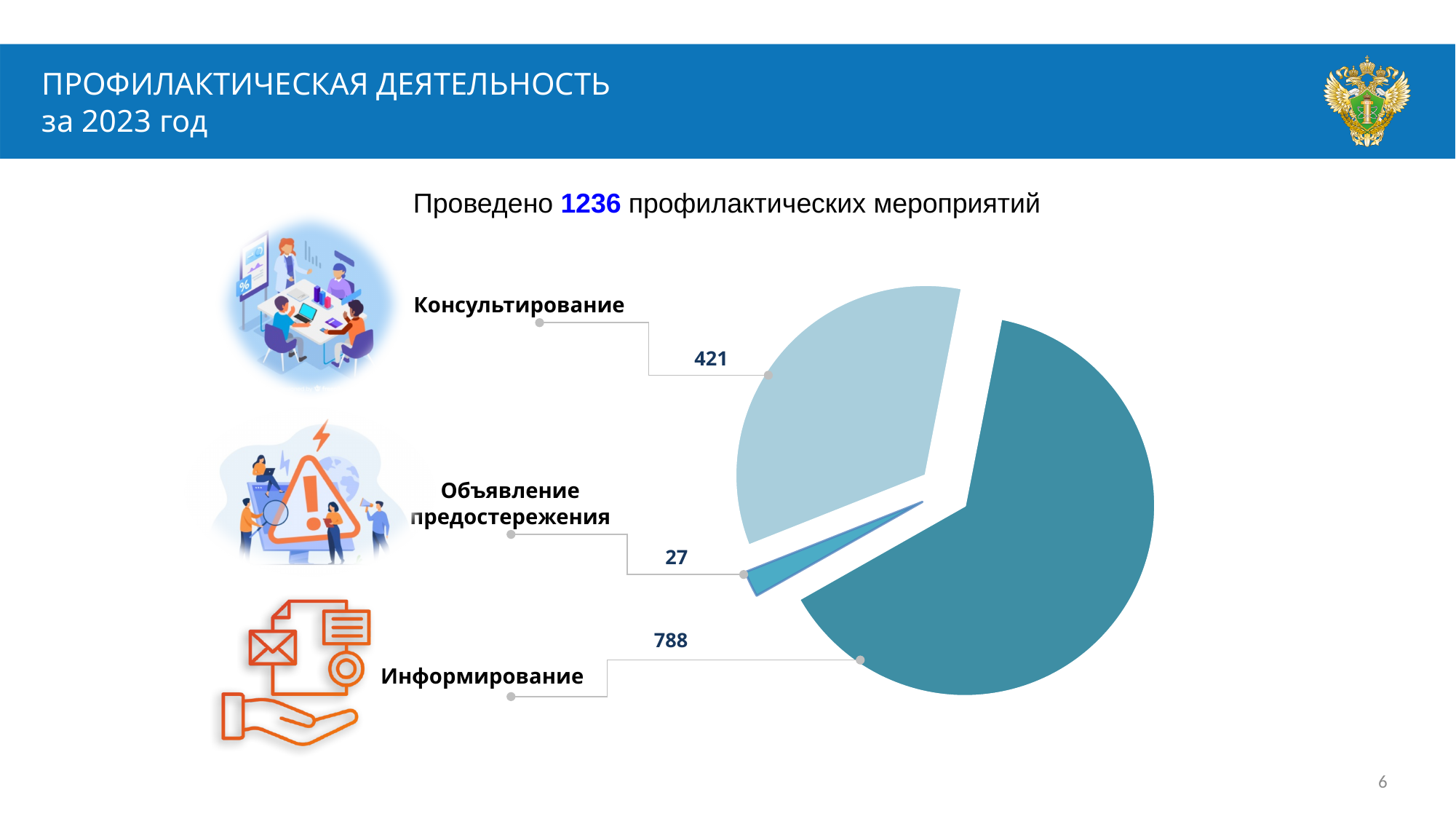
Which is larger, the value for Консультирование or the value for Информирование? Информирование What is the difference between the values for Консультирование and Объявление предостережения? 394 Which category has the largest slice of the pie chart? Информирование What is the value for Информирование? 788 What is the difference between the values for Информирование and Консультирование? 367 What is the total of all three slices in the pie chart? 1236 What is the value for Объявление предостережения? 27 How many slices does the pie chart have? 3 What type of chart is shown on the slide? pie chart What total number of preventive measures is stated above the chart? 1236 What is the value for Консультирование? 421 Which category has the smallest slice of the pie chart? Объявление предостережения